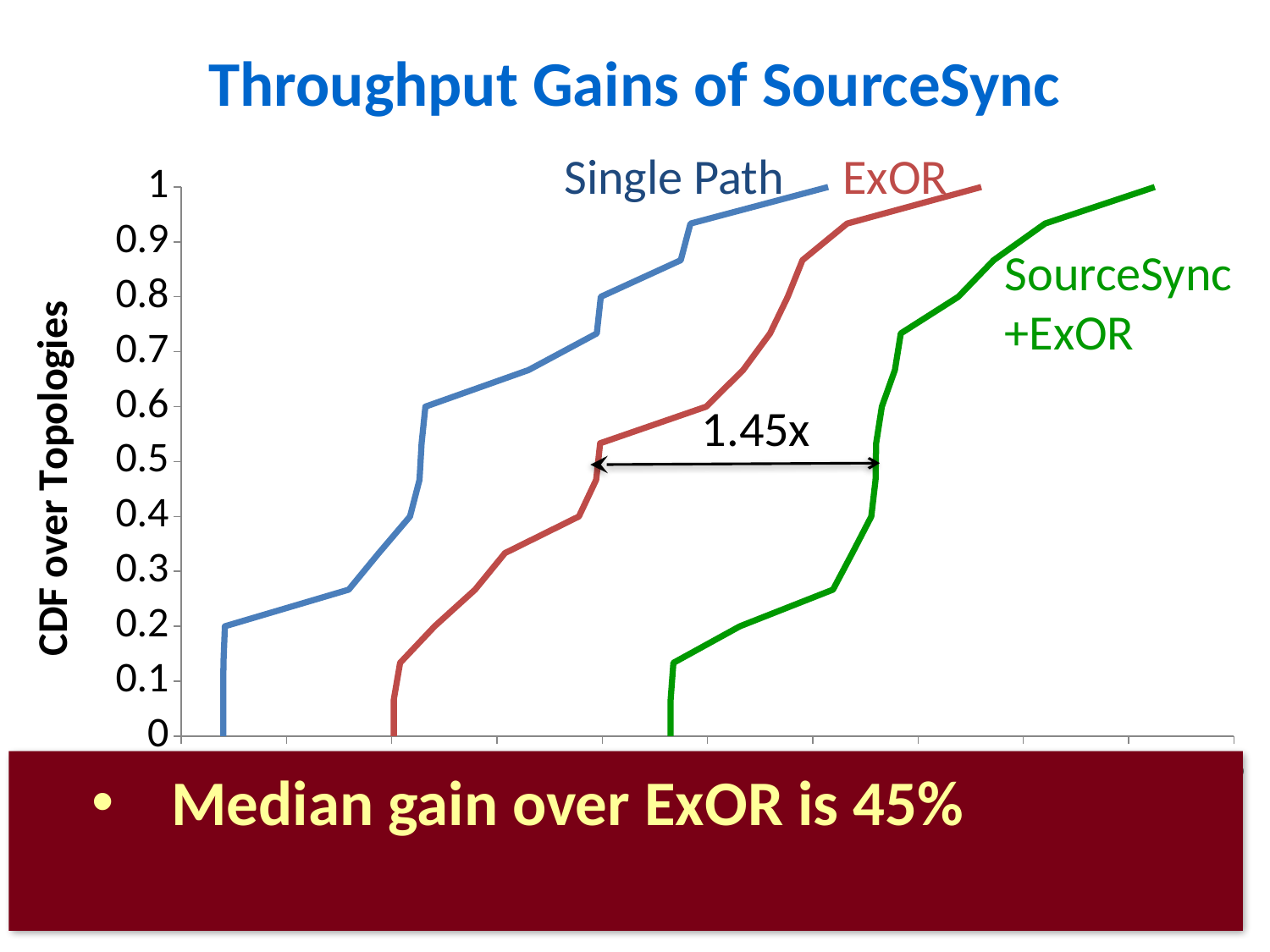
How many series (curves) are plotted on the chart? 3 At a CDF of 0.5, which curve is further to the left: Single Path or ExOR? Single Path Which curve lies furthest to the right on the chart? SourceSync+ExOR Do the curves rise or fall as you move along the x axis? rise According to the slide, what is the median gain over ExOR? 45% What is the highest tick value shown on the y axis? 1 What is the title of the chart on the slide? Throughput Gains of SourceSync Which curve lies furthest to the left on the chart? Single Path What kind of chart is shown on the slide? line chart What is the label of the y axis? CDF over Topologies At a CDF of 0.5, which curve is further to the right: ExOR or SourceSync+ExOR? SourceSync+ExOR What gain factor is annotated by the arrow between the ExOR and SourceSync+ExOR curves? 1.45x